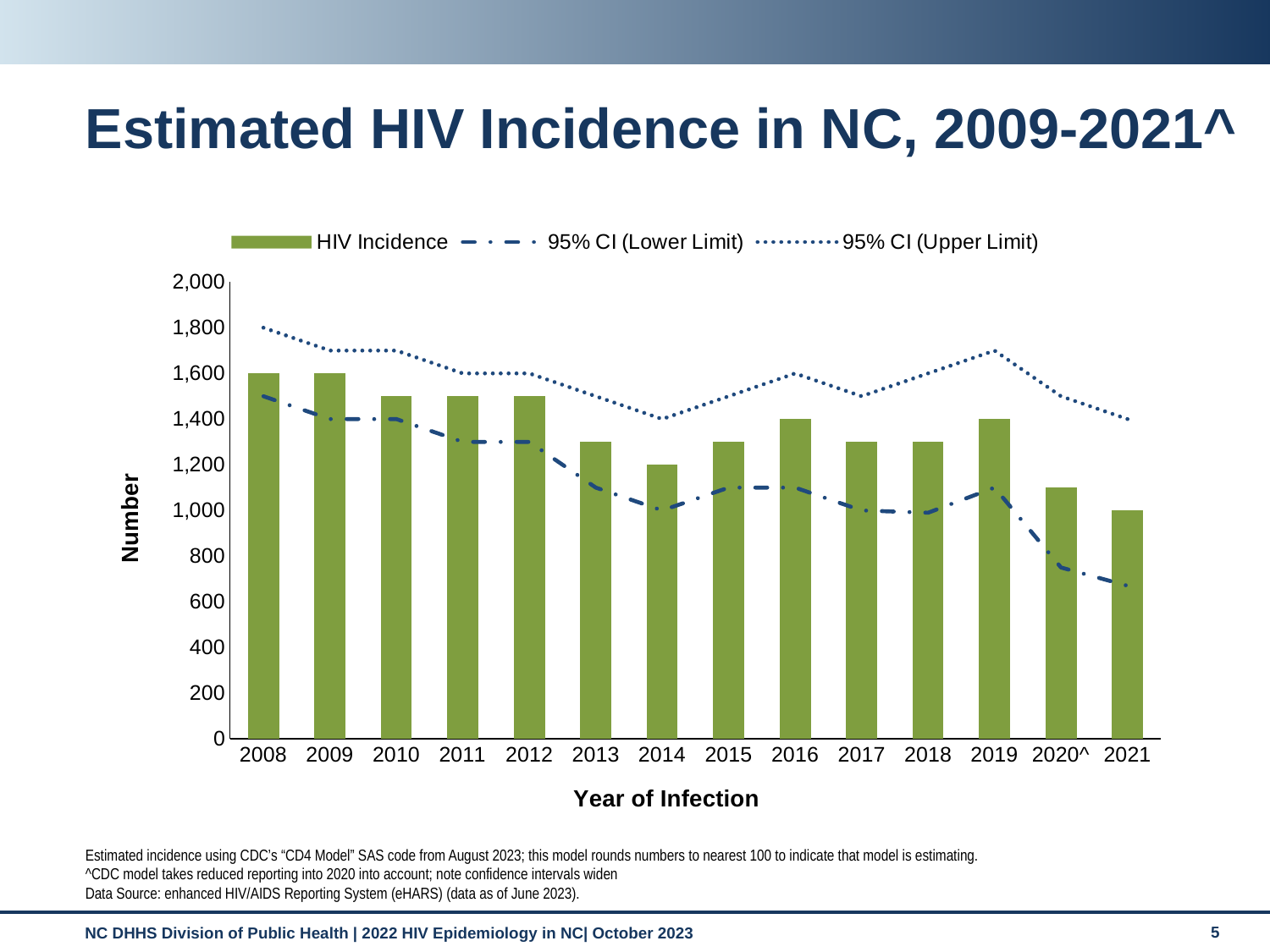
Is the HIV Incidence value for 2010 greater or less than 1,400? greater How many years are shown on the x axis? 14 What is the HIV Incidence value for 2014? 1,200 What is the HIV Incidence value for 2021? 1,000 Which year has the lowest HIV Incidence bar? 2021 What is the HIV Incidence value for 2008? 1,600 Does HIV Incidence generally rise or fall from 2008 to 2021? Fall What is the difference between the HIV Incidence values for 2008 and 2021? 600 What kind of chart is used to show the HIV Incidence series? Bar chart Which year has a higher HIV Incidence, 2016 or 2021? 2016 How many series does the legend list? 3 Is the HIV Incidence value for 2020^ greater or less than 1,200? less